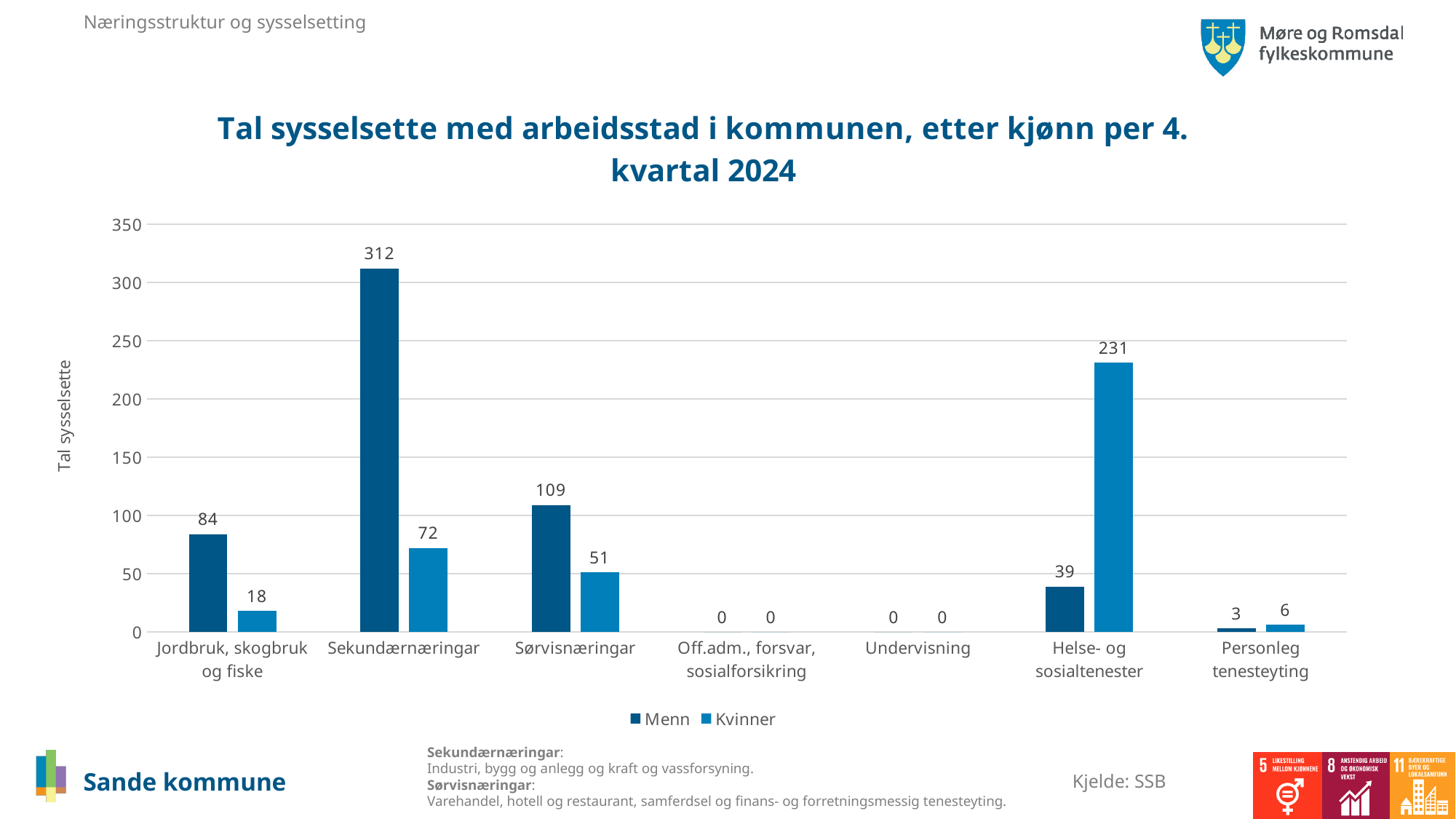
What is the value for Menn in Personleg tenesteyting? 3 Which category has the highest value for Kvinner? Helse- og sosialtenester What kind of chart is shown on the slide? Bar chart What is the value for Kvinner in Jordbruk, skogbruk og fiske? 18 How many series does the legend list? 2 Which is larger in Helse- og sosialtenester, Menn or Kvinner? Kvinner What is the difference between Menn and Kvinner in Sørvisnæringar? 58 How many categories are shown on the x axis? 7 What is the label of the y axis? Tal sysselsette What is the value for Kvinner in Helse- og sosialtenester? 231 Which category has the highest value for Menn? Sekundærnæringar What is the value for Menn in Sekundærnæringar? 312